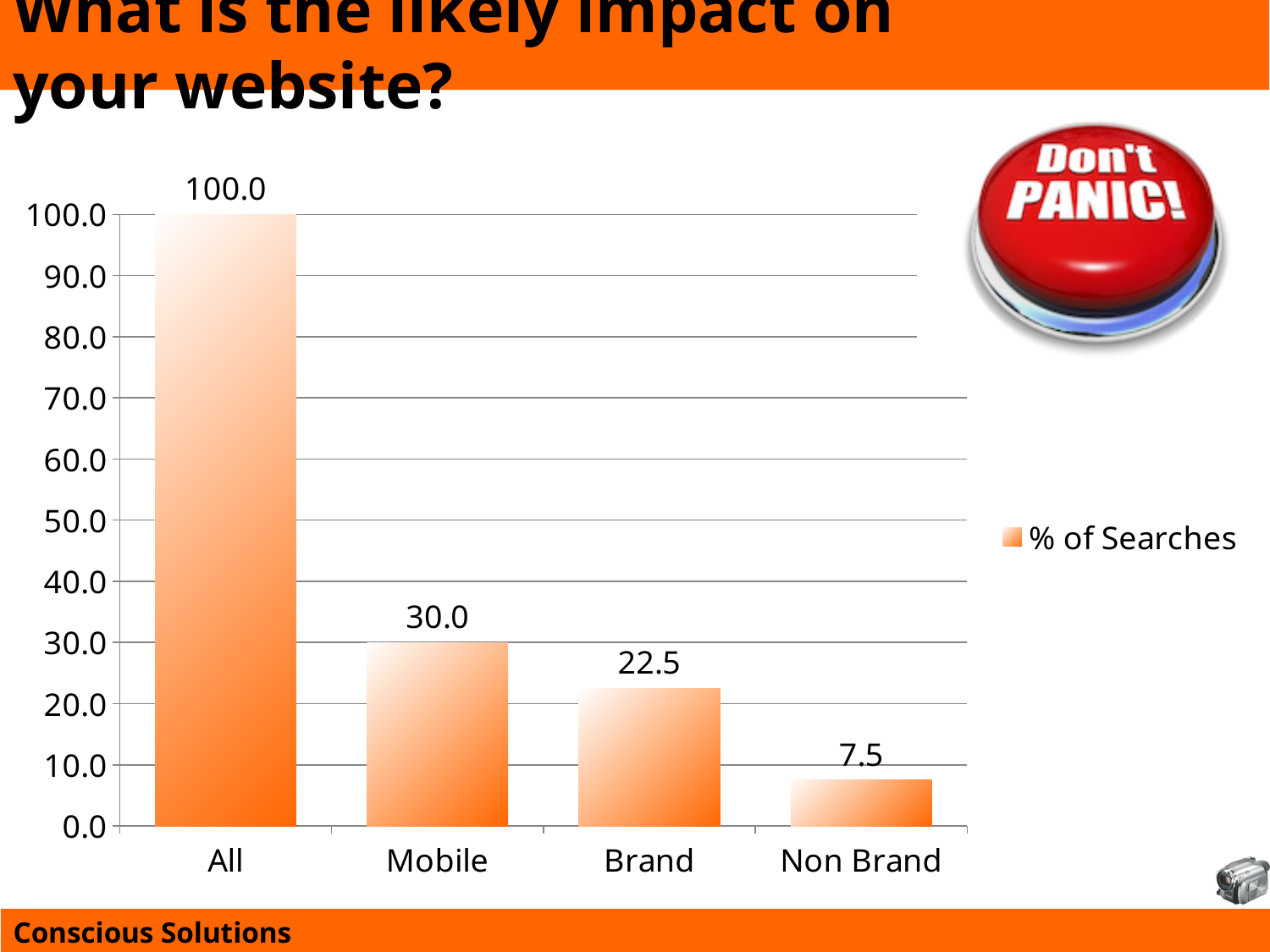
How many categories are shown on the x axis? 4 What is the value for Non Brand? 7.5 What series name does the legend show? % of Searches What is the difference between the values for Mobile and Brand? 7.5 Is the value for Brand greater or less than 20.0? greater Which category has the highest value? All What is the value for Brand? 22.5 Which is larger, the value for Brand or the value for Non Brand? Brand Which category has the lowest value? Non Brand What kind of chart is shown on the slide? bar chart What is the value for Mobile? 30.0 What is the difference between the values for All and Mobile? 70.0